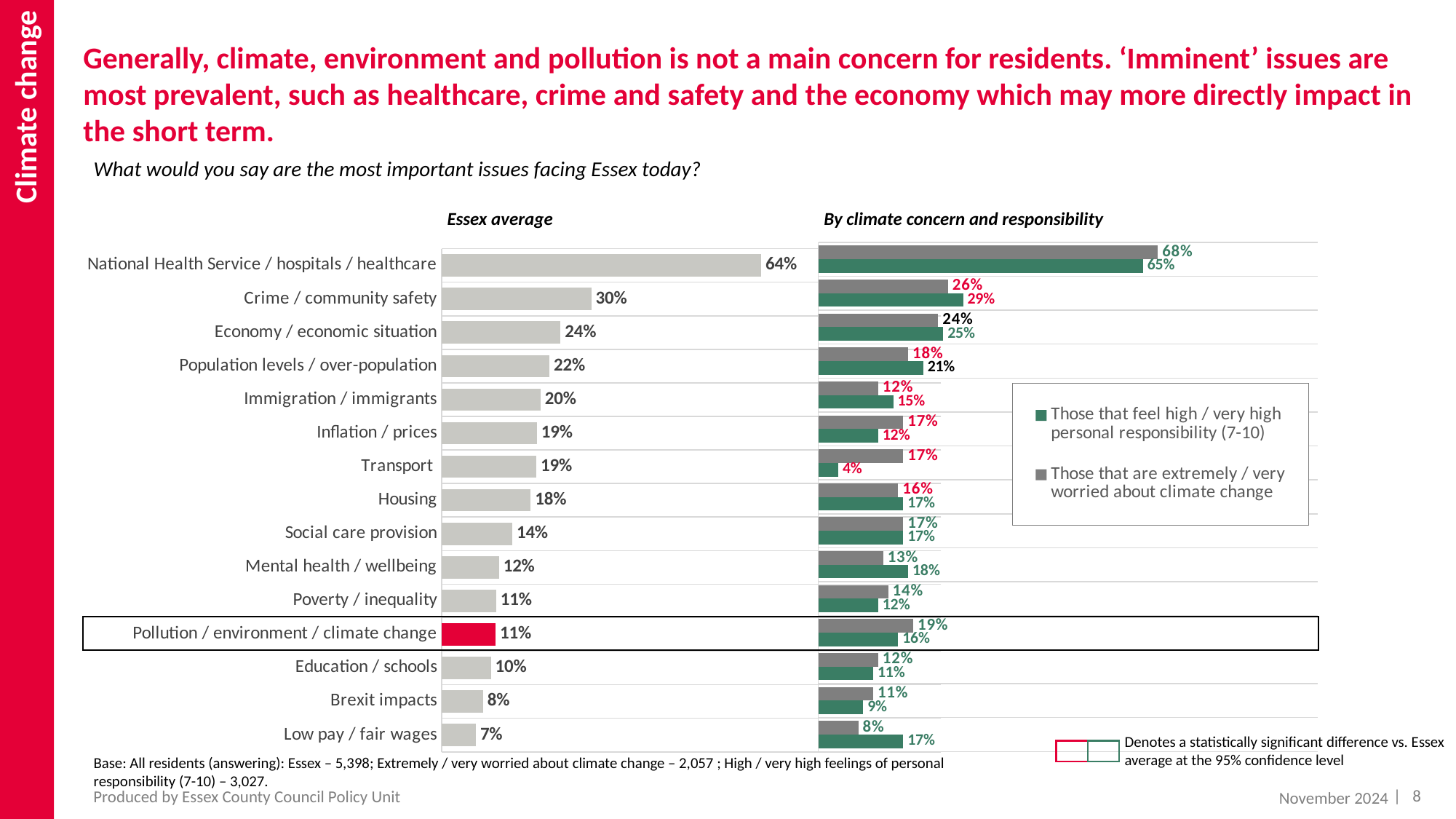
In the 'Essex average' chart, which category's bar is highlighted in red? Pollution / environment / climate change In the 'Essex average' chart, which category has the lowest value? Low pay / fair wages In the 'By climate concern and responsibility' chart, what is the value for Transport among those that feel high / very high personal responsibility (7-10)? 4% In the 'Essex average' chart, what is the value for Pollution / environment / climate change? 11% In the 'Essex average' chart, what is the value for National Health Service / hospitals / healthcare? 64% In the 'Essex average' chart, what is the difference between Crime / community safety and Economy / economic situation? 6% What kind of chart is the 'Essex average' chart? Bar chart In the 'By climate concern and responsibility' chart, which is larger for Crime / community safety: those that feel high / very high personal responsibility or those that are extremely / very worried about climate change? Those that feel high / very high personal responsibility (7-10) In the 'By climate concern and responsibility' chart, what is the difference between the two series for Transport? 13% In the 'Essex average' chart, how many categories are shown? 15 How many series does the legend of the 'By climate concern and responsibility' chart list? 2 In the 'By climate concern and responsibility' chart, what is the value for Low pay / fair wages among those that are extremely / very worried about climate change? 8%